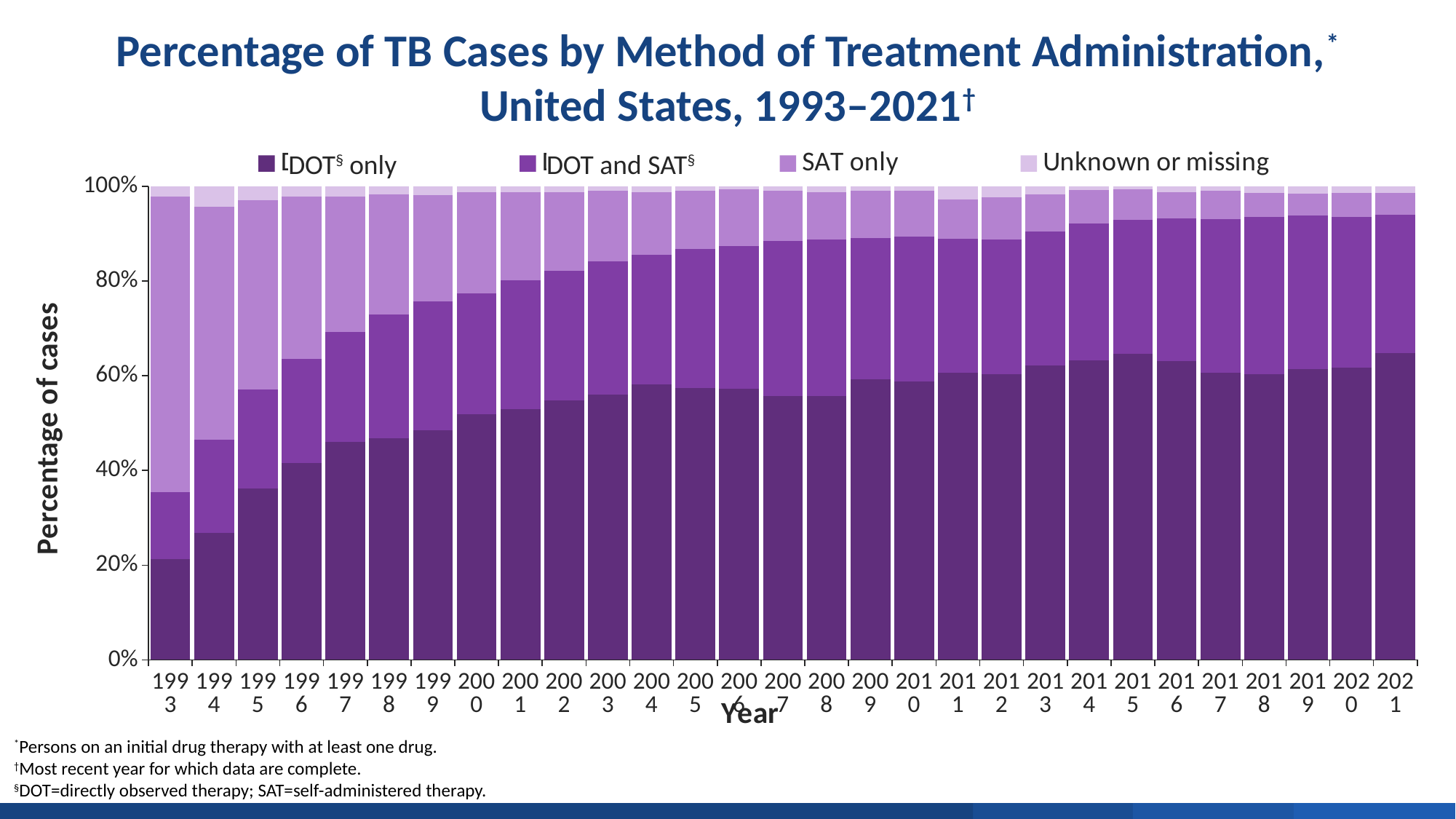
How many years are shown along the x axis? 29 What kind of chart is shown on the slide? Stacked bar chart How many series does the legend list? 4 Which is larger, the DOT only percentage in 1993 or in 2021? 2021 Is the DOT only value for 2000 greater or less than 60%? less Is the DOT only value for 2021 greater or less than 60%? greater Is the DOT only value for 1993 greater or less than 40%? less Does the DOT only percentage generally rise or fall from 1993 to 2021? rise Which year has the lowest percentage for DOT only? 1993 What is the label of the y axis? Percentage of cases Which year has the largest SAT only segment? 1993